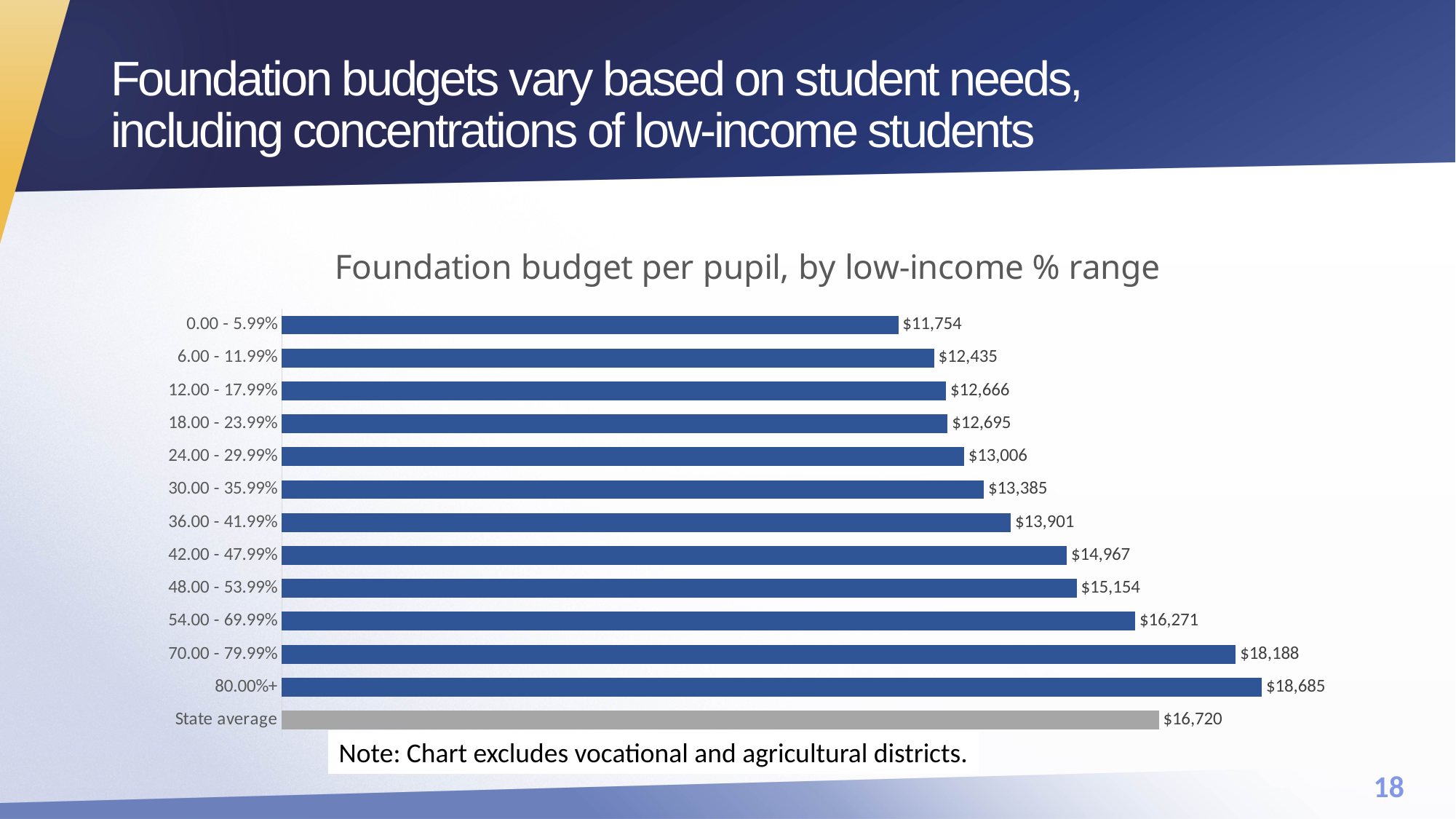
What is the State average foundation budget per pupil shown on the chart? $16,720 Do the foundation budget values rise or fall as the low-income % range increases from 0.00 - 5.99% to 80.00%+? Rise What is the difference between the foundation budget per pupil for the 80.00%+ range and the 0.00 - 5.99% range? $6,931 Which is larger: the foundation budget per pupil for the 54.00 - 69.99% range or the State average? State average What is the foundation budget per pupil for the 42.00 - 47.99% range? $14,967 What is the foundation budget per pupil for the 80.00%+ low-income range? $18,685 What is the foundation budget per pupil for the 0.00 - 5.99% low-income range? $11,754 Which low-income % range has the lowest foundation budget per pupil? 0.00 - 5.99% What type of chart is shown on the slide? Bar chart How many bars are shown on the chart, including the State average? 13 What is the difference between the 70.00 - 79.99% range and the State average? $1,468 Which low-income % range has the highest foundation budget per pupil? 80.00%+